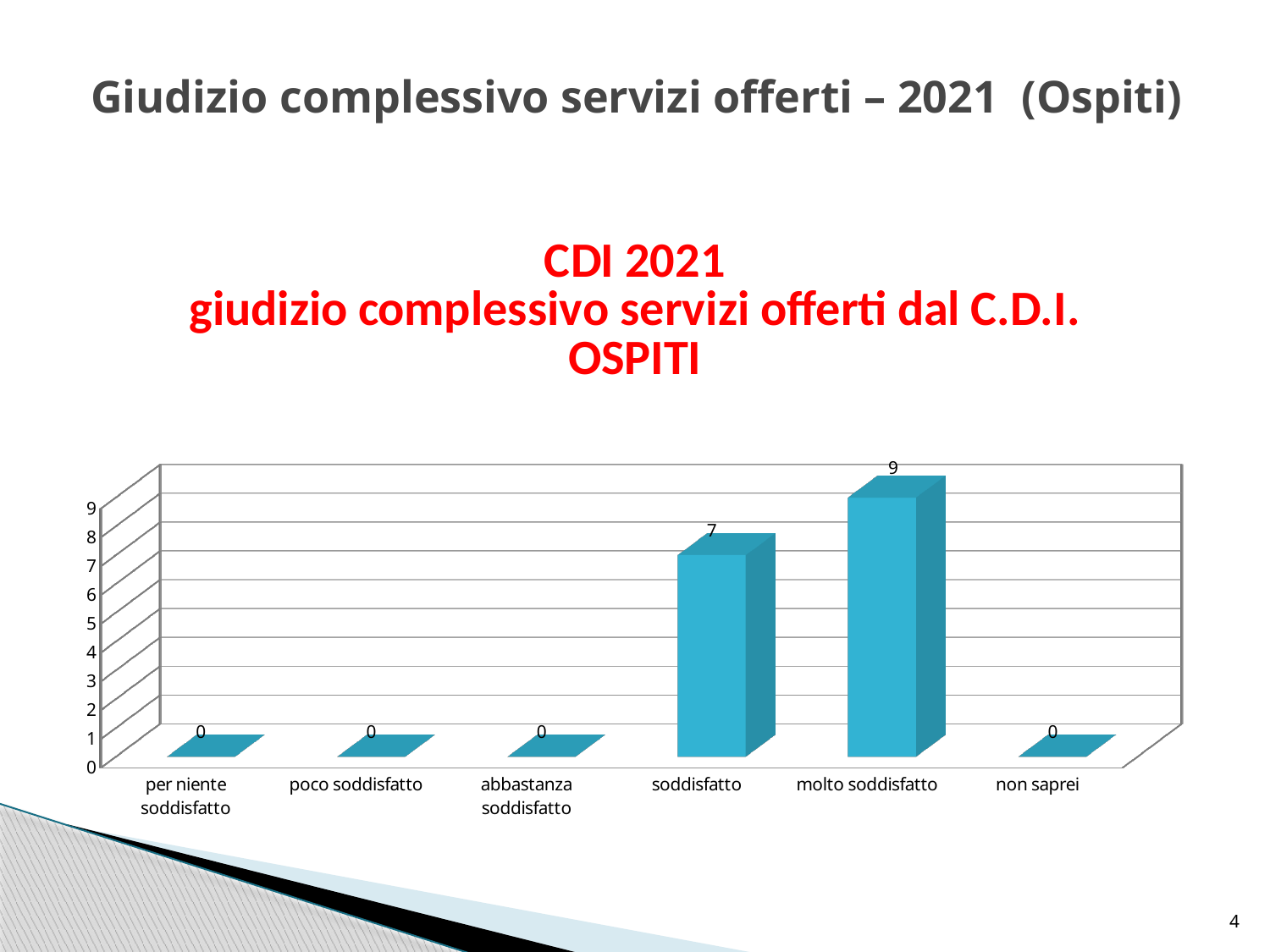
What is the first line of the chart title? CDI 2021 How many categories are shown on the x axis? 6 How many categories have a value of 0? 4 Which is larger, the value for "soddisfatto" or the value for "molto soddisfatto"? molto soddisfatto What is the value for "molto soddisfatto"? 9 What kind of chart is shown on the slide? bar chart What is the value for "non saprei"? 0 What is the difference between the values for "molto soddisfatto" and "soddisfatto"? 2 What is the value for "soddisfatto"? 7 Which category has the highest value? molto soddisfatto What is the total of the values for "soddisfatto" and "molto soddisfatto"? 16 What is the value for "per niente soddisfatto"? 0